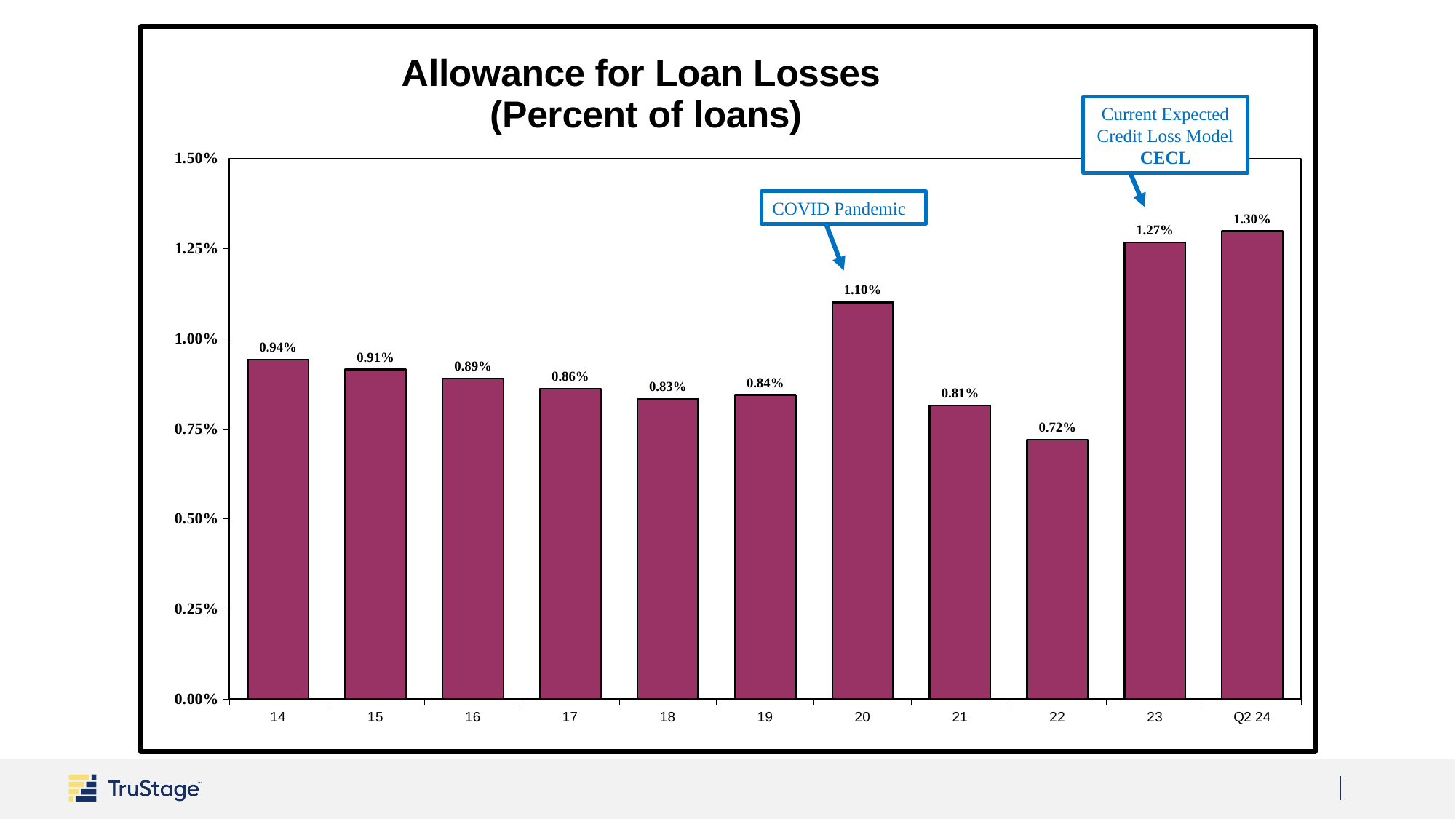
What is the difference between the values for 23 and 22? 0.55% Which is larger, the value for 14 or the value for 19? 14 What is the value shown for 22? 0.72% Which category has the highest allowance for loan losses? Q2 24 What kind of chart is shown on the slide? bar chart How many bars are shown in the chart? 11 Is the value for 21 greater or less than 1.00%? less What is the value shown for Q2 24? 1.30% Which event does the callout above the 20 bar label? COVID Pandemic What is the allowance for loan losses as a percent of loans in 20? 1.10% Which year has the lowest allowance for loan losses? 22 Do the values rise or fall from 14 to 18? fall